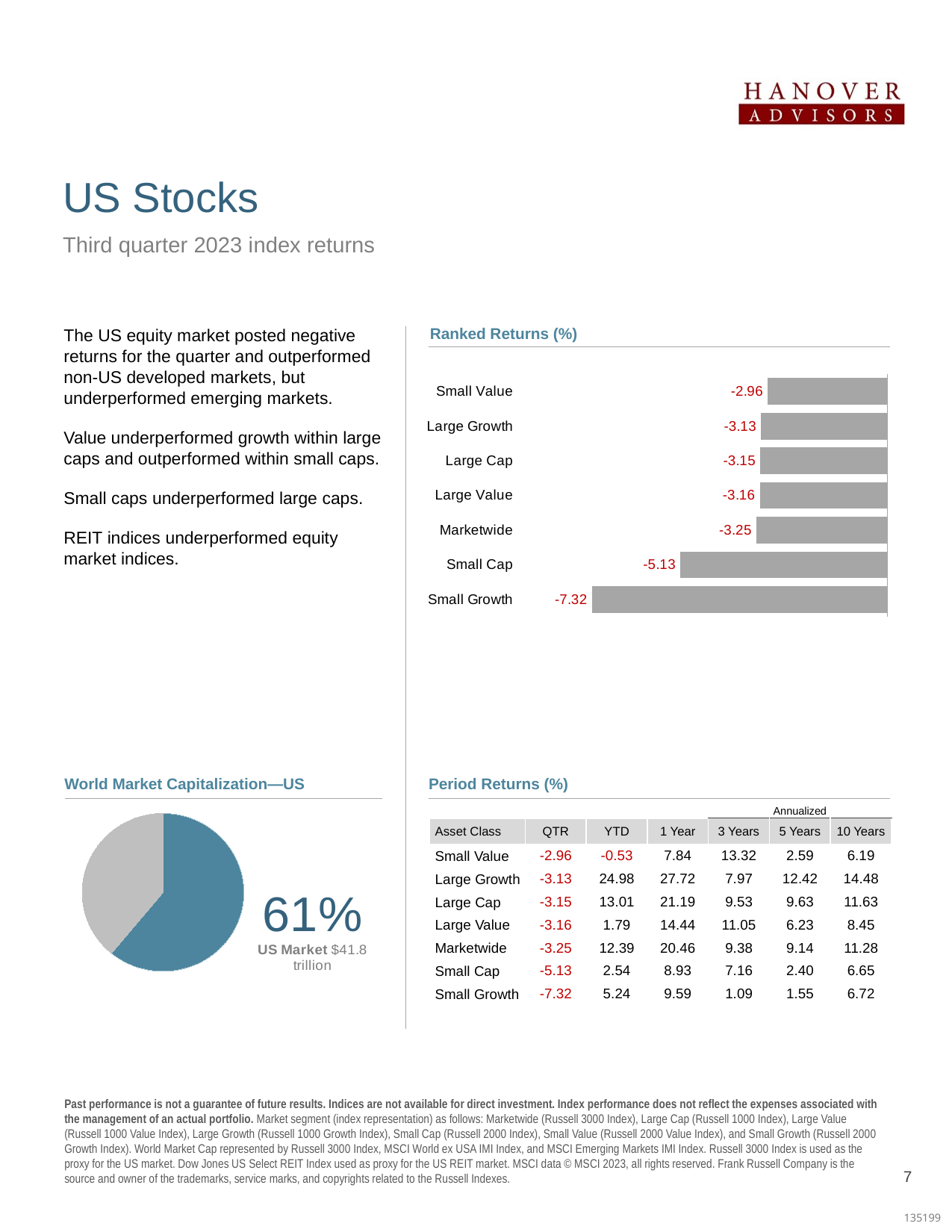
In the Ranked Returns (%) chart, what is the difference between the values for Small Cap and Small Growth? 2.19 In the Ranked Returns (%) chart, what is the value for Small Value? -2.96 In the Ranked Returns (%) chart, what is the value for Small Growth? -7.32 In the Ranked Returns (%) chart, what is the value for Marketwide? -3.25 In the Ranked Returns (%) chart, which category has the lowest value? Small Growth How many categories are shown in the Ranked Returns (%) chart? 7 In the World Market Capitalization—US chart, what share of the pie does the US Market represent? 61% In the Ranked Returns (%) chart, which category has the highest value? Small Value In the Ranked Returns (%) chart, which is larger, the value for Large Cap or the value for Small Cap? Large Cap What is the title of the bar chart on the slide? Ranked Returns (%) What kind of chart is the World Market Capitalization—US chart? Pie chart What kind of chart is the Ranked Returns (%) chart? Bar chart